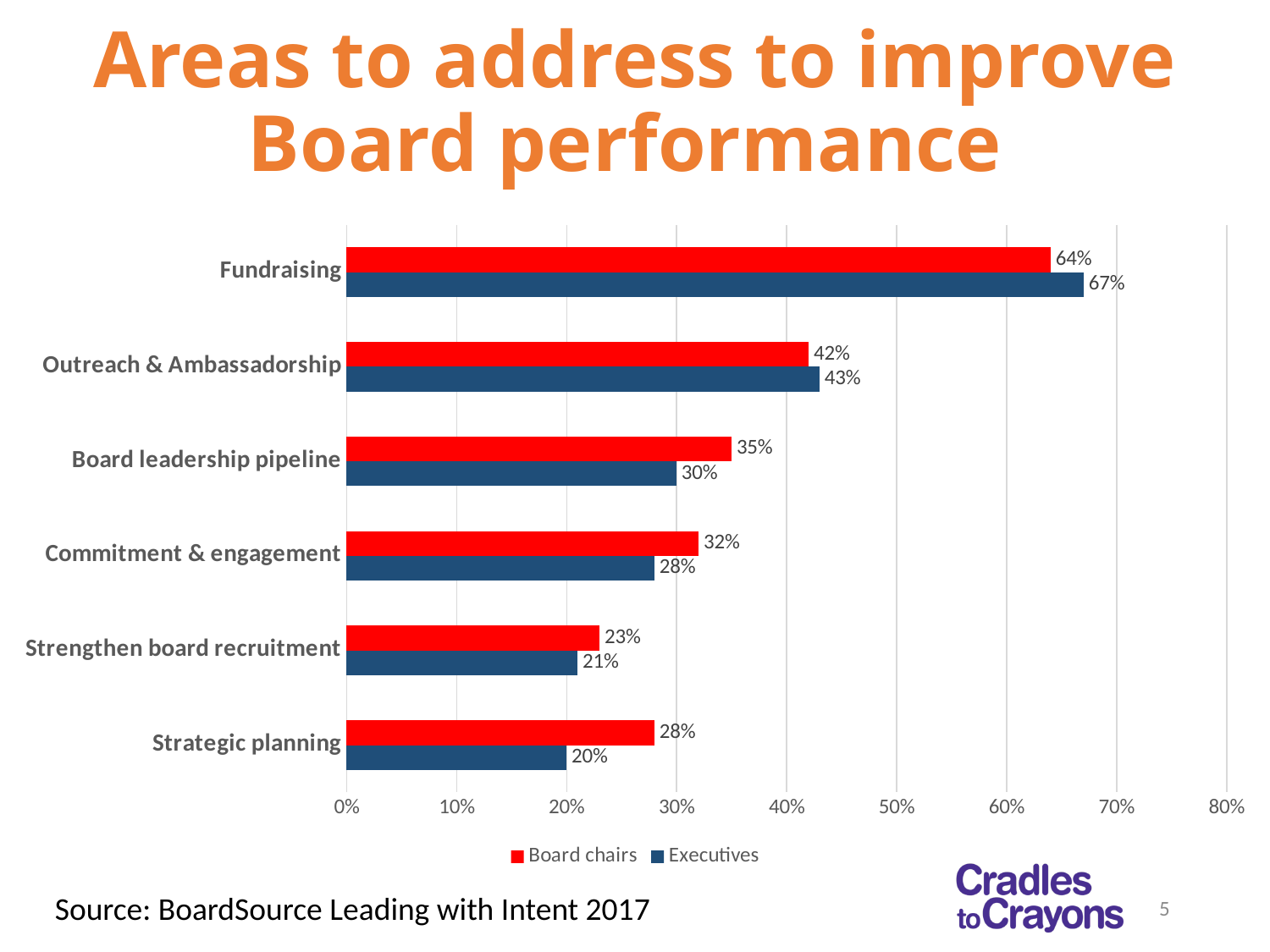
What is the Executives value for Strategic planning? 20% What is the difference between the Board chairs and Executives values for Fundraising? 3% For Commitment & engagement, which series has the larger value, Board chairs or Executives? Board chairs What is the Board chairs value for Fundraising? 64% Which category has the highest Executives value? Fundraising Which category has the lowest Board chairs value? Strengthen board recruitment What is the difference between the Executives and Board chairs values for Strategic planning? 8% Is the Executives value for Outreach & Ambassadorship greater or less than 40%? greater How many series does the legend list? 2 How many categories are shown on the chart? 6 What kind of chart is shown on the slide? Bar chart What is the Executives value for Board leadership pipeline? 30%